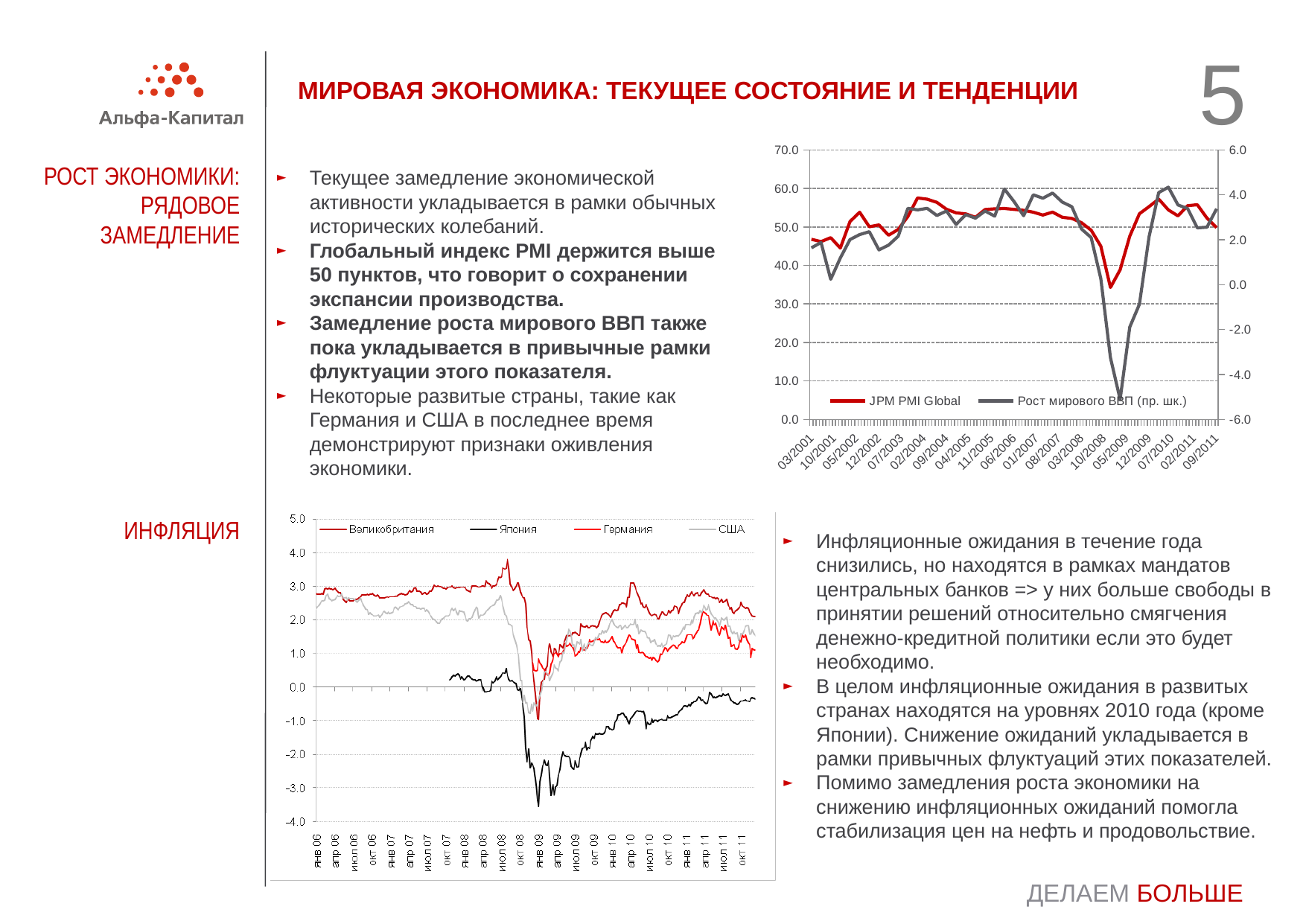
How many series does the legend of the bottom-left chart list? 4 What kind of chart is the bottom-left inflation chart? line chart In the bottom-left chart, which series has the lowest value at the end of the period (окт 11)? Япония What is the maximum value shown on the left axis of the top-right chart? 70.0 In the top-right chart, is the value of JPM PMI Global around 05/2009 greater or less than 40.0? less In the bottom-left chart, is the lowest value of the Япония series around янв 09 greater or less than -3.0? less In the bottom-left chart, which series has the highest value at the end of the period (окт 11)? Великобритания In the top-right chart, which series is plotted on the right-hand axis according to the legend? Рост мирового ВВП (пр. шк.) How many series does the legend of the top-right chart list? 2 What kind of chart is the top-right chart with the JPM PMI Global series? line chart In the top-right chart, is the value of Рост мирового ВВП around 05/2009 greater or less than -4.0 on the right axis? less